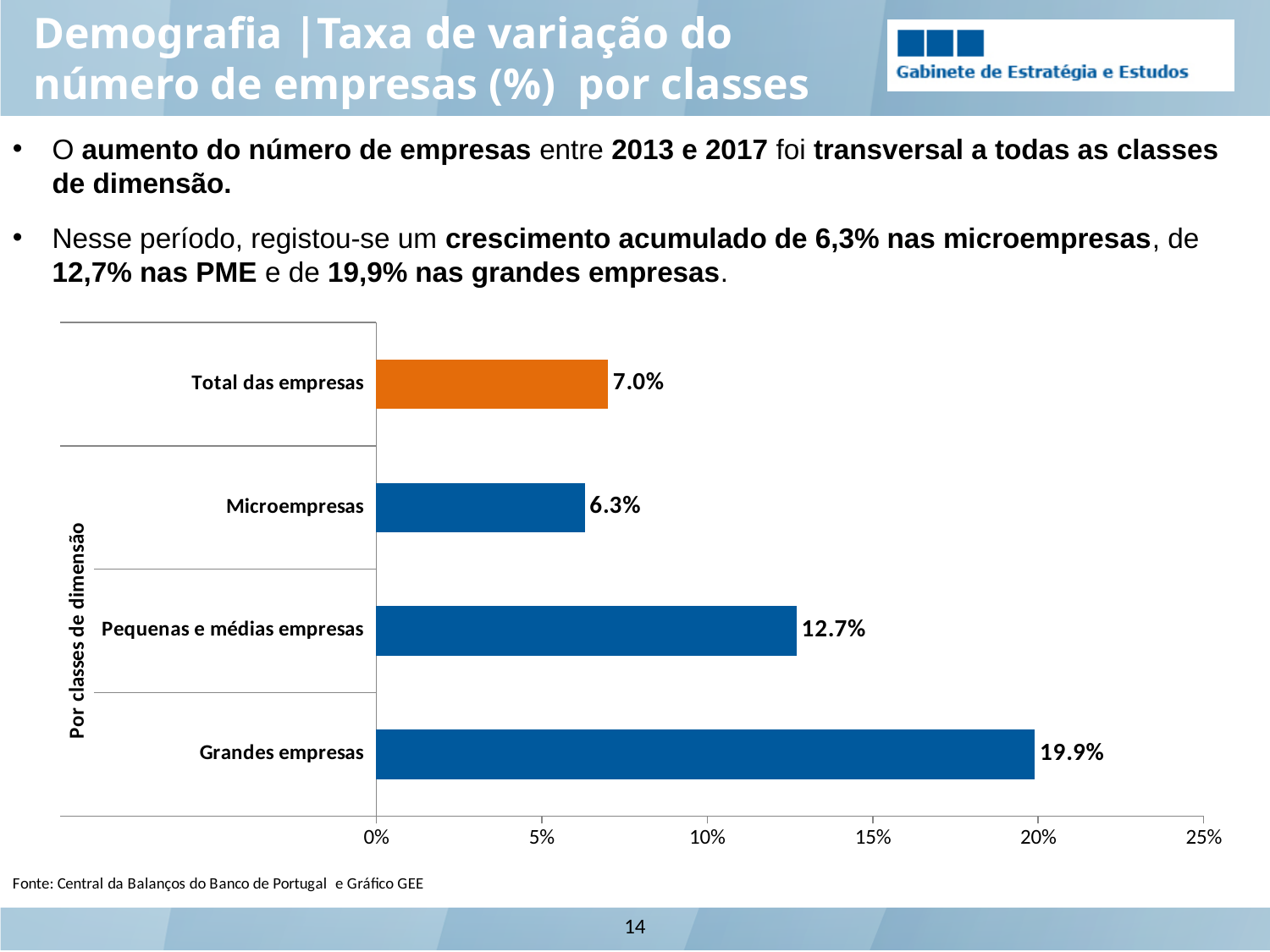
Which category has the highest value? Grandes empresas What is the value for Pequenas e médias empresas? 12.7% What is the label of the vertical axis of the chart? Por classes de dimensão What kind of chart is shown on the slide? Bar chart How many categories are shown in the chart? 4 What is the difference between the values for Grandes empresas and Pequenas e médias empresas? 7.2% Which is larger, the value for Total das empresas or the value for Microempresas? Total das empresas What is the value for Total das empresas? 7.0% What is the value for Grandes empresas? 19.9% What is the value for Microempresas? 6.3% Which category has the lowest value? Microempresas Is the value for Pequenas e médias empresas greater or less than 10%? greater